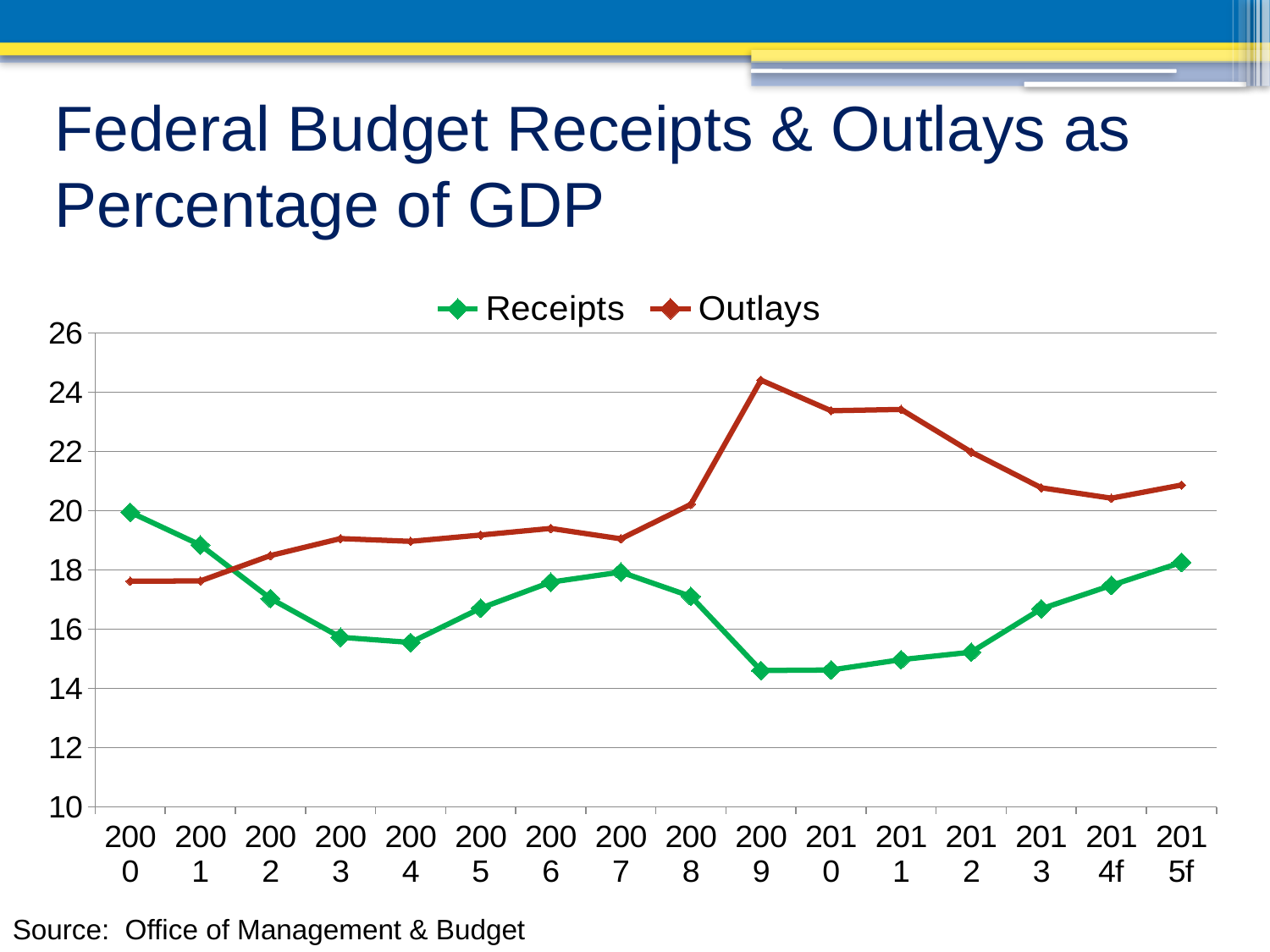
What kind of chart is shown on the slide? line chart Is the value for Receipts in 2009 greater or less than 16? less How many years are plotted along the x axis? 16 In which year do Outlays reach their highest value? 2009 Is the value for Outlays in 2012 greater or less than 20? greater In 2010, which is larger, Receipts or Outlays? Outlays Is the value for Outlays in 2009 greater or less than 24? greater In which year are Receipts at their highest? 2000 How many series does the legend list? 2 Which colour is used for the Receipts line? green Do Outlays rise or fall from 2009 to 2014f? fall In 2000, which is larger, Receipts or Outlays? Receipts